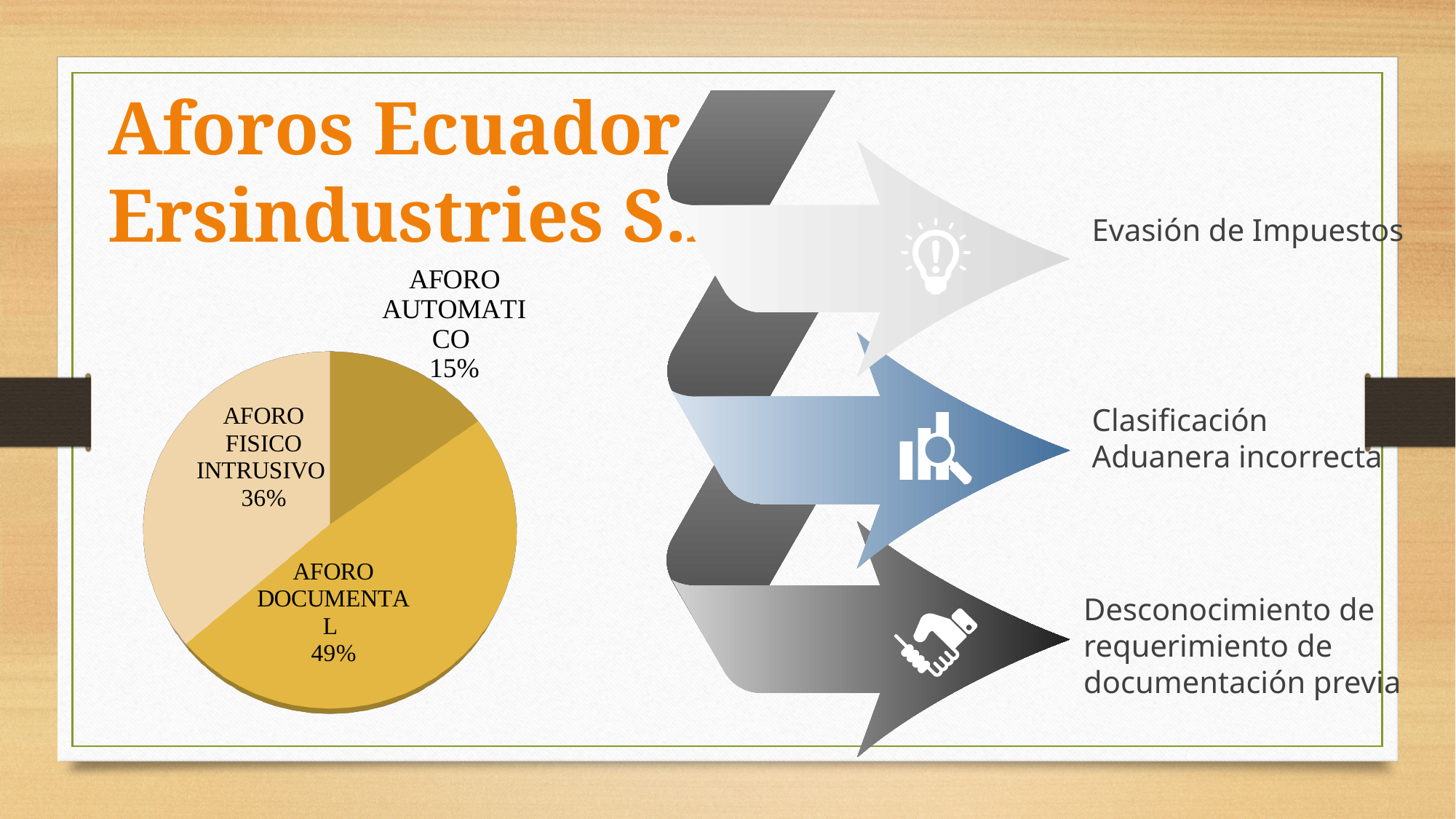
Which category has the largest slice of the pie? AFORO DOCUMENTAL What is the difference in percentage points between AFORO FISICO INTRUSIVO and AFORO AUTOMATICO? 21 Which is larger, the slice for AFORO FISICO INTRUSIVO or the slice for AFORO AUTOMATICO? AFORO FISICO INTRUSIVO What is the difference in percentage points between AFORO DOCUMENTAL and AFORO FISICO INTRUSIVO? 13 What kind of chart is shown on the slide? pie chart How many slices does the pie chart have? 3 Which is larger, the slice for AFORO DOCUMENTAL or the slice for AFORO FISICO INTRUSIVO? AFORO DOCUMENTAL What share of the pie does AFORO FISICO INTRUSIVO have? 36% What share of the pie does AFORO DOCUMENTAL have? 49% Which category has the smallest slice of the pie? AFORO AUTOMATICO What share of the pie does AFORO AUTOMATICO have? 15%